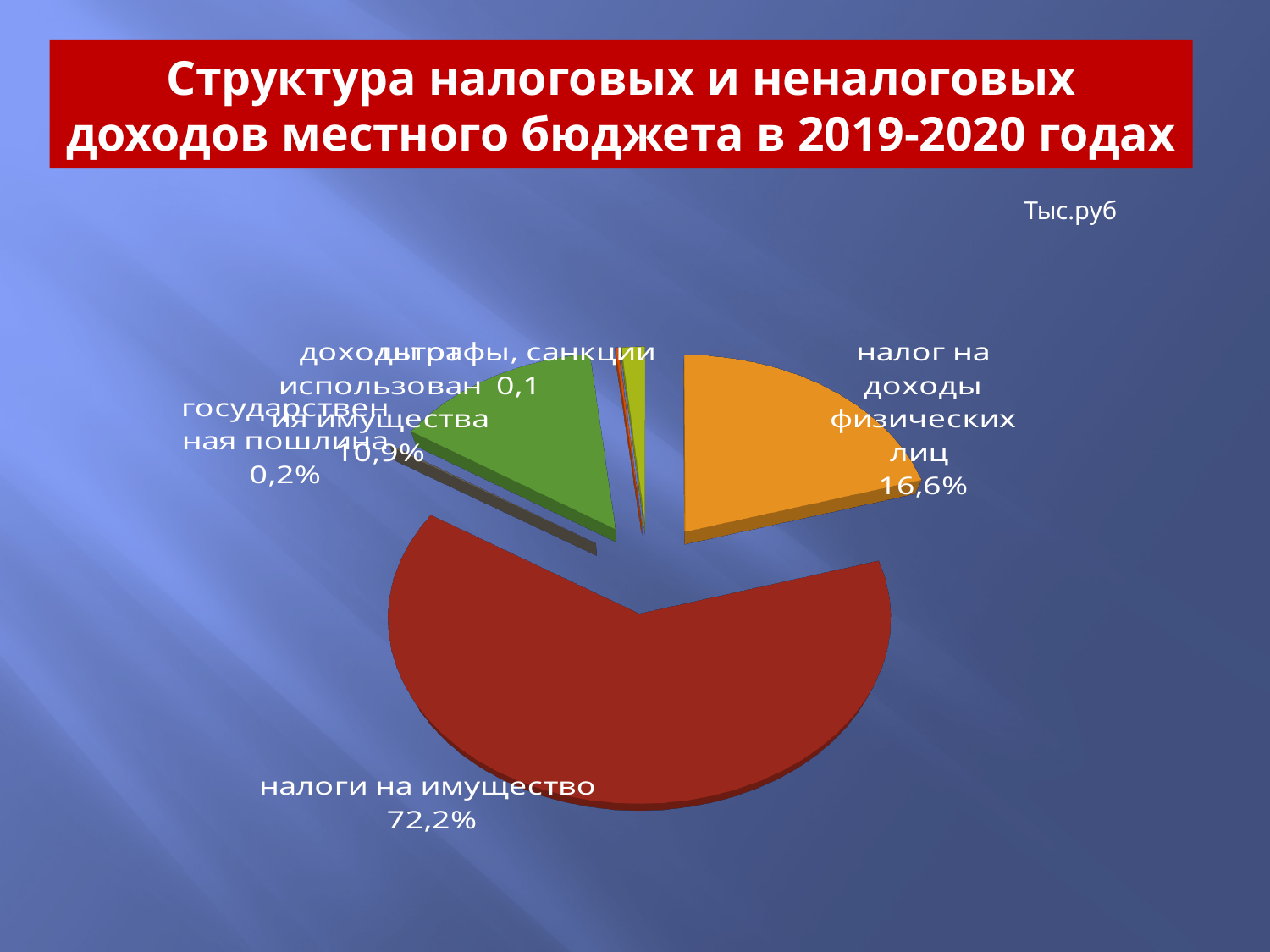
What is the difference between the shares of "налоги на имущество" and "налог на доходы физических лиц"? 55,6 percentage points What is the value shown for "налог на доходы физических лиц"? 16,6% What is the value shown for "доходы от использования имущества"? 10,9% What kind of chart is shown on the slide? pie chart What is the value shown for "штрафы, санкции"? 0,1 Which category has the smallest slice of the pie? штрафы, санкции Which category has the largest slice of the pie? налоги на имущество What share of the pie does "налоги на имущество" take? 72,2% Which is larger: the share of "налог на доходы физических лиц" or the share of "доходы от использования имущества"? налог на доходы физических лиц What is the value shown for "государственная пошлина"? 0,2% How many slices does the pie chart have? 6 What colour is the slice for "налоги на имущество"? red